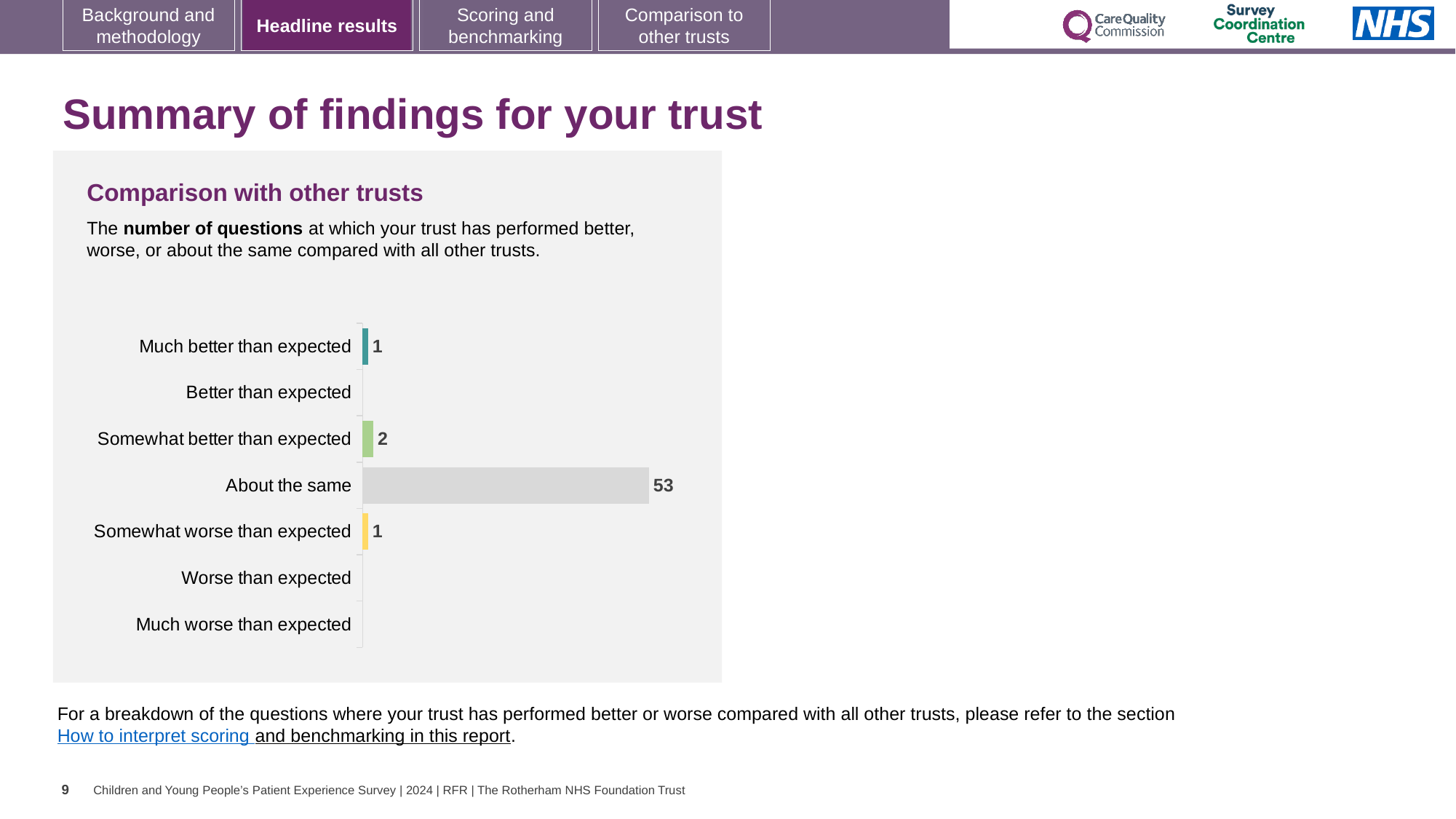
How many questions are in the 'About the same' category? 53 Which category has the highest number of questions? About the same Which is larger: the value for 'Somewhat better than expected' or the value for 'Somewhat worse than expected'? Somewhat better than expected What is the value for 'Much better than expected'? 1 What is the title of the chart? Comparison with other trusts What is the difference between the 'About the same' value and the 'Somewhat better than expected' value? 51 What is the total number of questions across all categories shown with values? 57 What is the value for 'Somewhat worse than expected'? 1 What kind of chart is shown on the slide? Bar chart What colour is the bar for 'About the same'? Grey How many categories are listed on the chart's axis? 7 What is the value for 'Somewhat better than expected'? 2